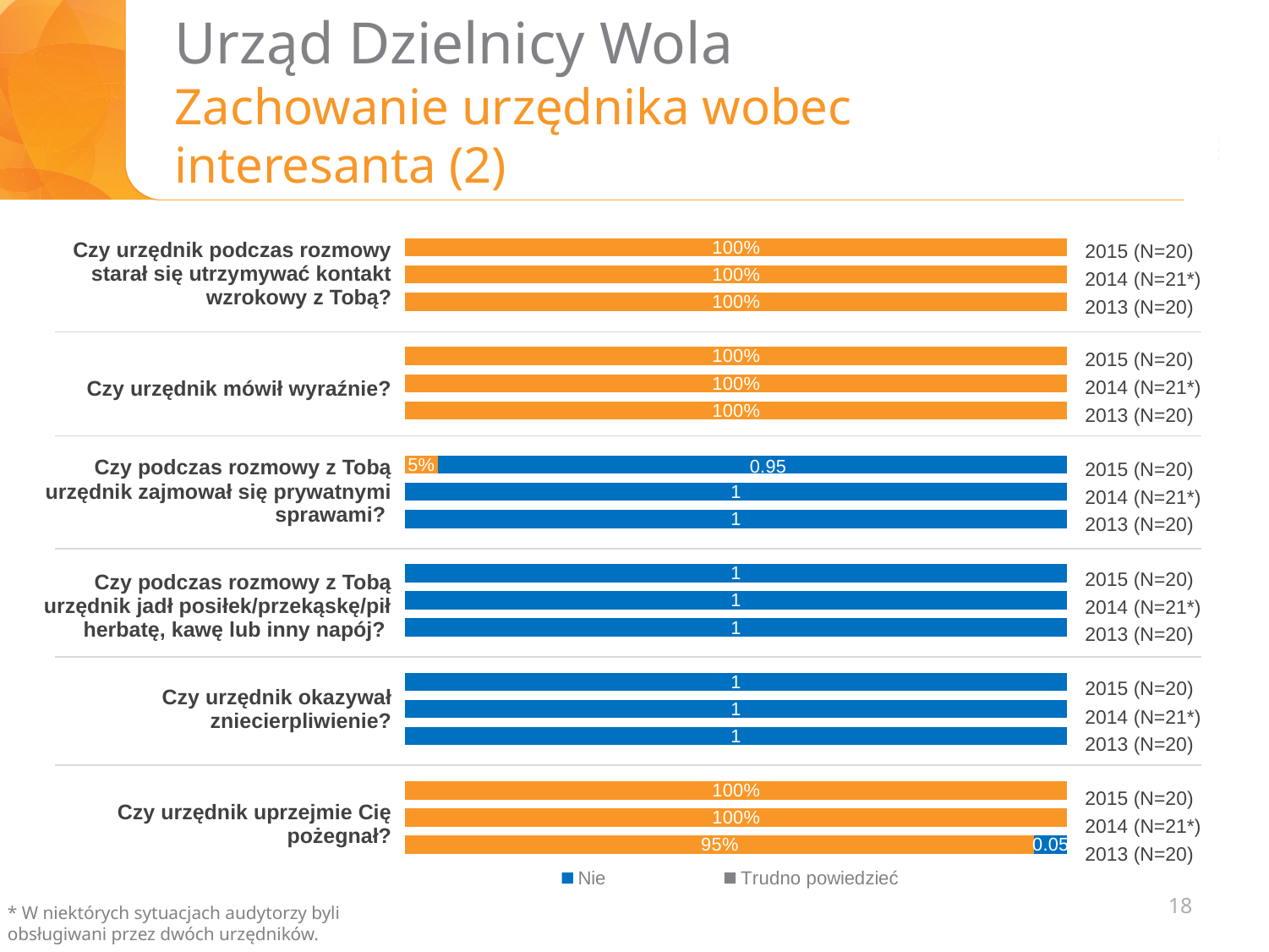
Which entries does the chart legend list? Nie, Trudno powiedzieć What value is printed on the blue bar for 2015 (N=20) for the question "Czy podczas rozmowy z Tobą urzędnik zajmował się prywatnymi sprawami?"? 0.95 What value is printed on the bar for 2015 (N=20) for the question "Czy urzędnik mówił wyraźnie?"? 100% What value is printed on the small segment at the right end of the 2013 (N=20) bar for "Czy urzędnik uprzejmie Cię pożegnał?"? 0.05 For "Czy urzędnik uprzejmie Cię pożegnał?", which year has the larger orange bar value, 2015 or 2013? 2015 How many survey questions are shown in the chart? 6 For "Czy urzędnik uprzejmie Cię pożegnał?", what is the difference between the orange bar values for 2015 (100%) and 2013 (95%)? 5% What kind of chart is shown on the slide? Bar chart What value is printed on the small orange segment for 2015 (N=20) for the question "Czy podczas rozmowy z Tobą urzędnik zajmował się prywatnymi sprawami?"? 5% How many years are shown for each survey question in the chart? 3 What value is printed on the orange bar for 2013 (N=20) for the question "Czy urzędnik uprzejmie Cię pożegnał?"? 95% What is the sample size (N) given for 2014 in the chart? 21